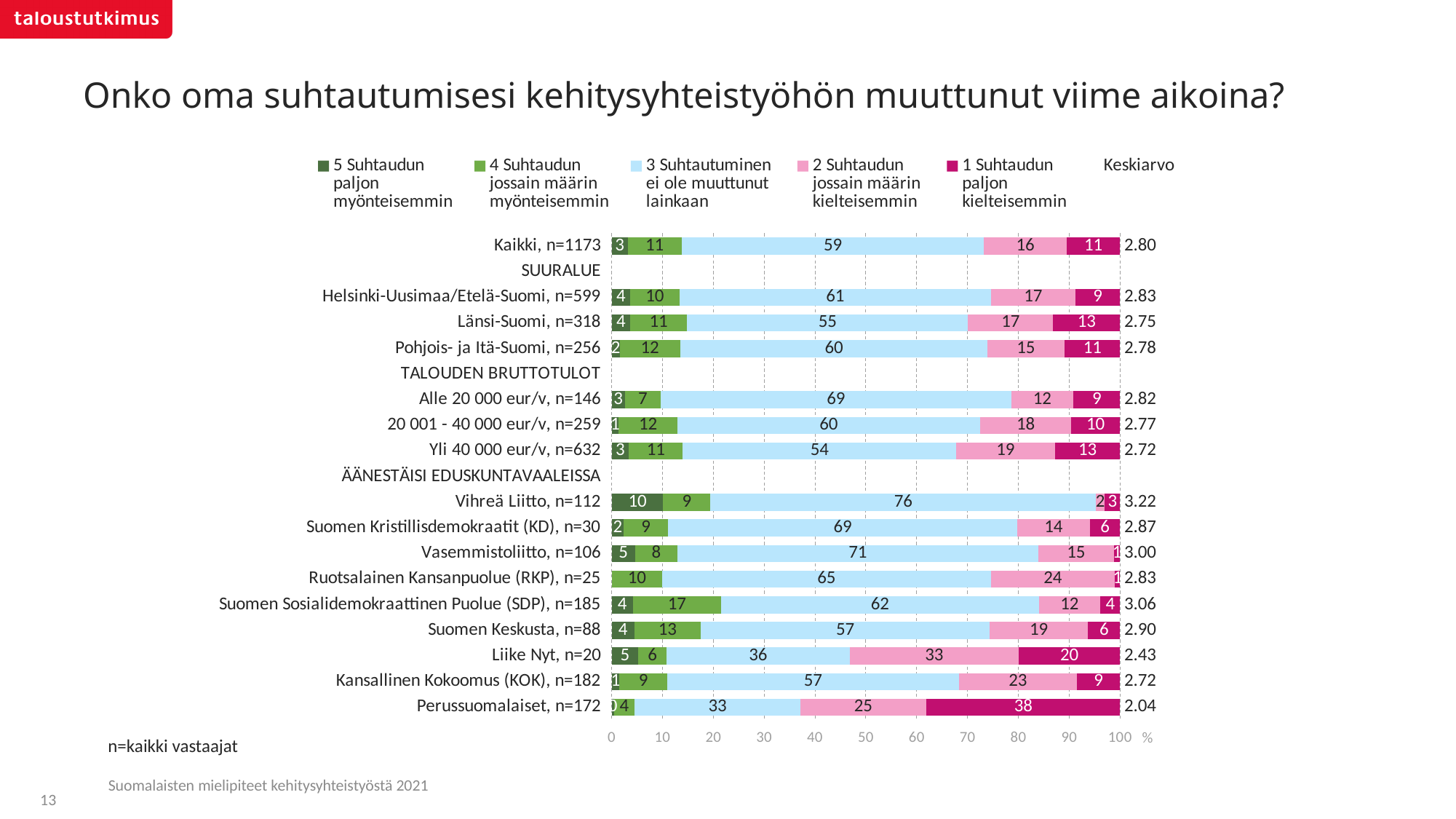
How many coloured series does the legend list? 5 What is the value for "1 Suhtaudun paljon kielteisemmin" in the Perussuomalaiset, n=172 bar? 38 What is the title of the chart? Onko oma suhtautumisesi kehitysyhteistyöhön muuttunut viime aikoina? What is the Keskiarvo shown for Vihreä Liitto, n=112? 3.22 Which category has the lowest Keskiarvo value? Perussuomalaiset, n=172 Which category has the highest value for "1 Suhtaudun paljon kielteisemmin"? Perussuomalaiset, n=172 Which category has the highest Keskiarvo value? Vihreä Liitto, n=112 What is the value for "3 Suhtautuminen ei ole muuttunut lainkaan" in the Kaikki, n=1173 bar? 59 What is the value for "4 Suhtaudun jossain määrin myönteisemmin" in the Suomen Sosialidemokraattinen Puolue (SDP), n=185 bar? 17 What is the difference between the "2 Suhtaudun jossain määrin kielteisemmin" values for Liike Nyt, n=20 and Kaikki, n=1173? 17 Which has the larger "3 Suhtautuminen ei ole muuttunut lainkaan" value, Vihreä Liitto, n=112 or Vasemmistoliitto, n=106? Vihreä Liitto, n=112 What kind of chart is shown on the slide? Stacked bar chart